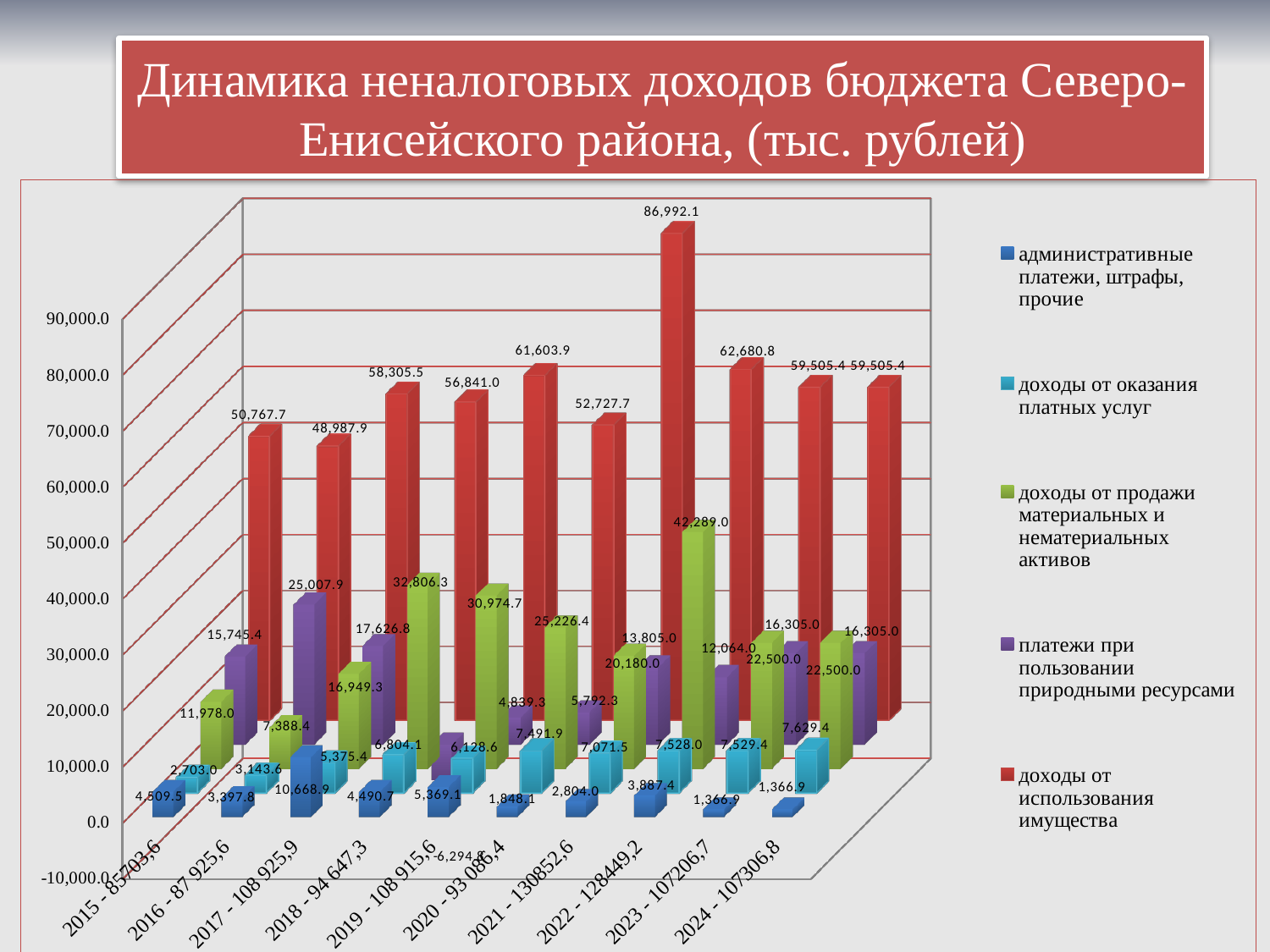
What is the value of 'доходы от продажи материальных и нематериальных активов' for the category '2022 - 128449,2'? 42,289.0 What is the value of 'доходы от оказания платных услуг' for the category '2024 - 107306,8'? 7,629.4 What is the difference between 'доходы от использования имущества' in '2021 - 130852,6' and in '2022 - 128449,2'? 24,311.3 Which is larger for 'доходы от продажи материальных и нематериальных активов': the value for '2018 - 94 647,3' or for '2019 - 108 915,6'? 2018 - 94 647,3 What kind of chart is shown on the slide? bar chart How many categories (years) are shown along the x axis? 10 How many series does the legend list? 5 What is the value of 'административные платежи, штрафы, прочие' for the category '2017 - 108 925,9'? 10,668.9 In which category is 'доходы от использования имущества' the highest? 2021 - 130852,6 What colour represents 'доходы от использования имущества' in the legend? red In which category is 'доходы от использования имущества' the lowest? 2016 - 87 925,6 What is the value of 'доходы от использования имущества' for the category '2015 - 85 703,6'? 50,767.7